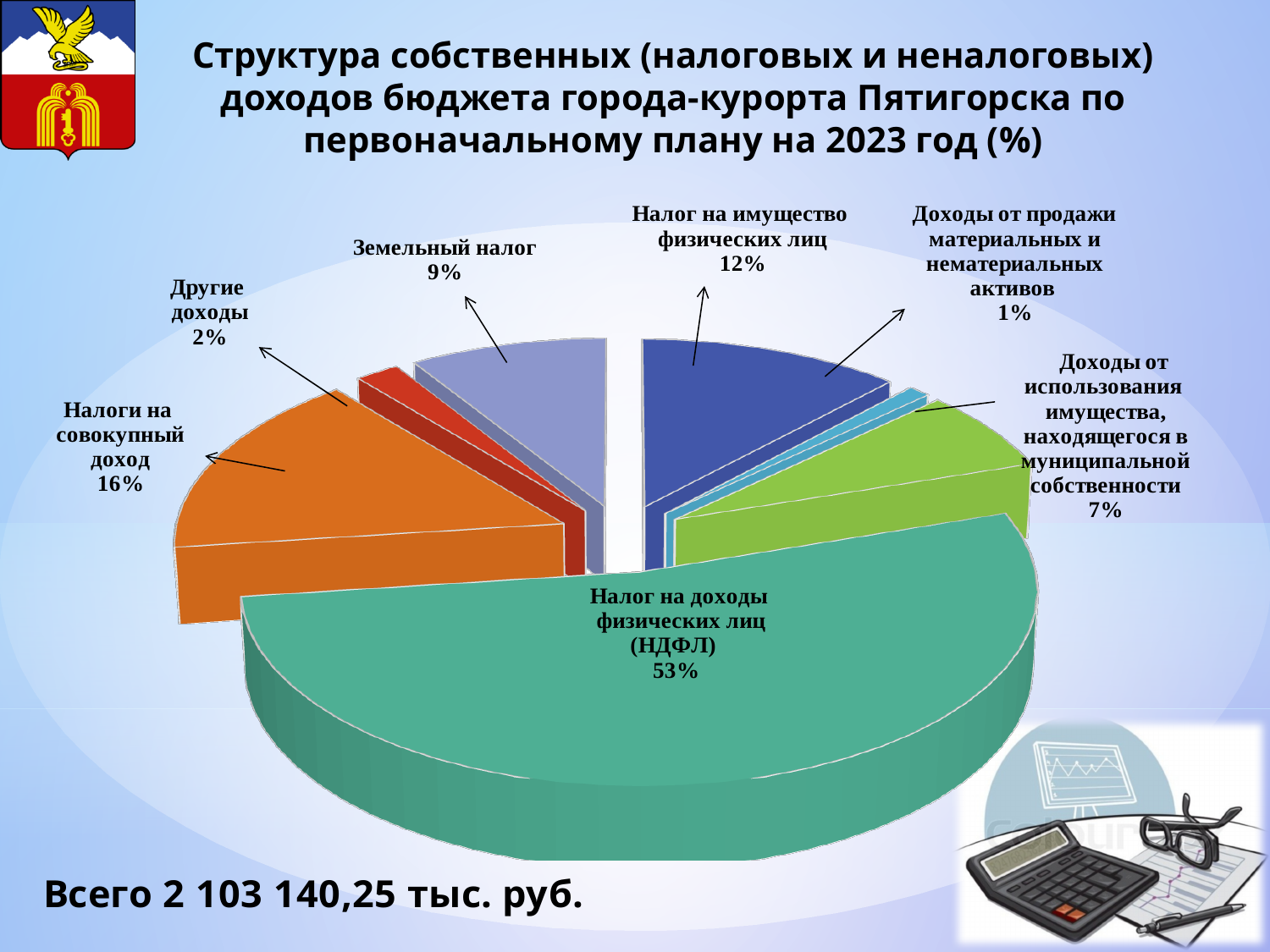
Which category has the smallest share of the pie? Доходы от продажи материальных и нематериальных активов What percentage is shown for Налоги на совокупный доход? 16% Which category has the largest share of the pie? Налог на доходы физических лиц (НДФЛ) What total amount of own revenues is stated on the slide? 2 103 140,25 тыс. руб. Which is larger: the share of Земельный налог or the share of Другие доходы? Земельный налог What percentage is shown for Доходы от использования имущества, находящегося в муниципальной собственности? 7% What is the difference in percentage points between Налоги на совокупный доход and Налог на имущество физических лиц? 4 How many categories (slices) does the pie chart have? 7 For which year does the chart show the planned structure of own revenues? 2023 What percentage is shown for Земельный налог? 9% What type of chart is shown on the slide? Pie chart What share of the budget's own revenues does Налог на доходы физических лиц (НДФЛ) account for? 53%